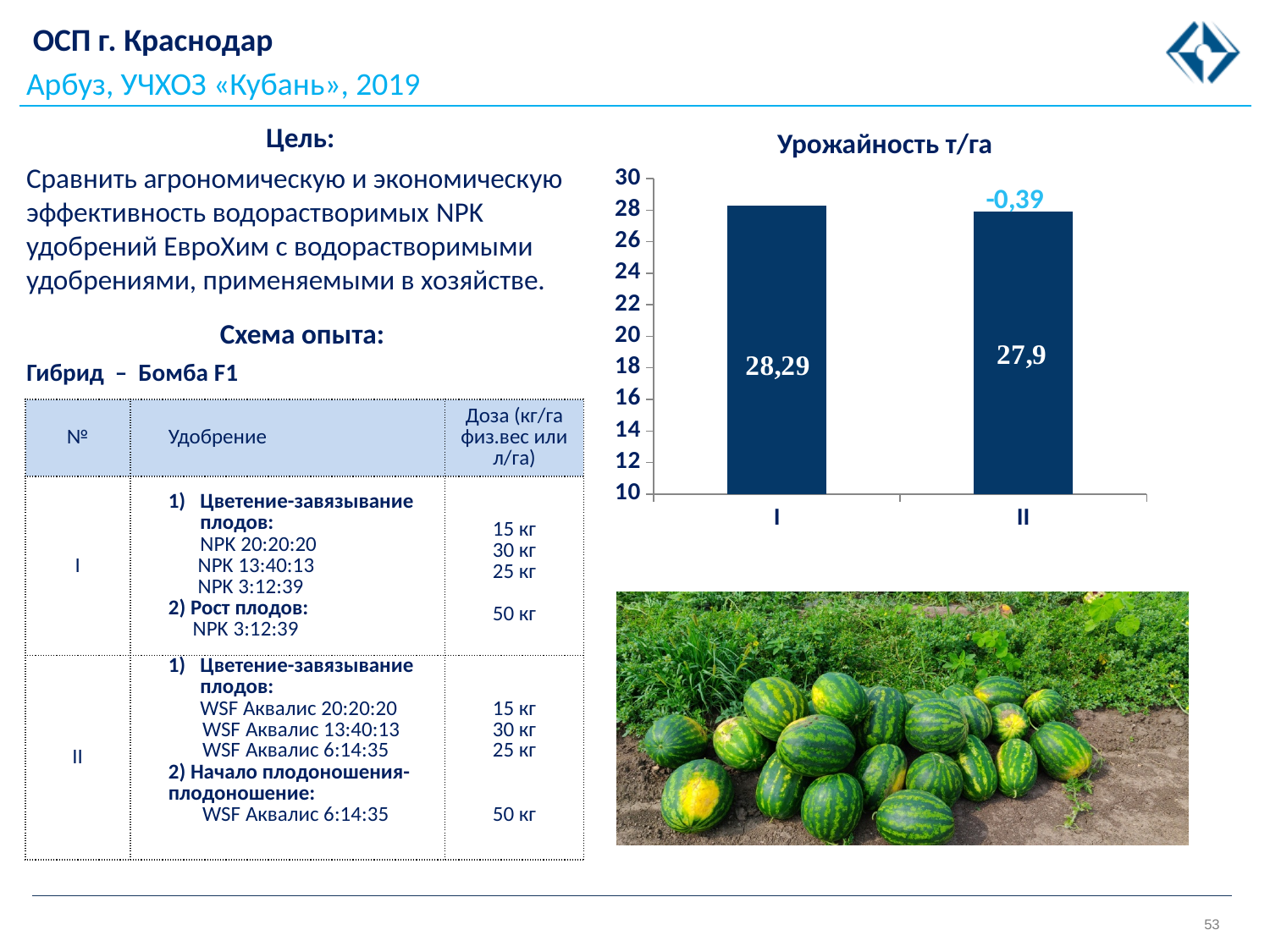
Which category has the lower yield in the chart 'Урожайность т/га'? II What is the yield value for category I in the chart 'Урожайность т/га'? 28,29 What is the yield value for category II in the chart 'Урожайность т/га'? 27,9 Which category has the higher yield in the chart 'Урожайность т/га'? I Is the yield for category I greater or less than 28? greater What is the title of the chart on the slide? Урожайность т/га What difference value is annotated above the bar for II in the chart? -0,39 What type of chart is used to show 'Урожайность т/га'? bar chart How many categories are shown in the chart 'Урожайность т/га'? 2 Do the values rise or fall from category I to category II in the chart? fall Is the yield for category II greater or less than 28? less What is the difference between the yield for I and the yield for II in the chart? 0,39